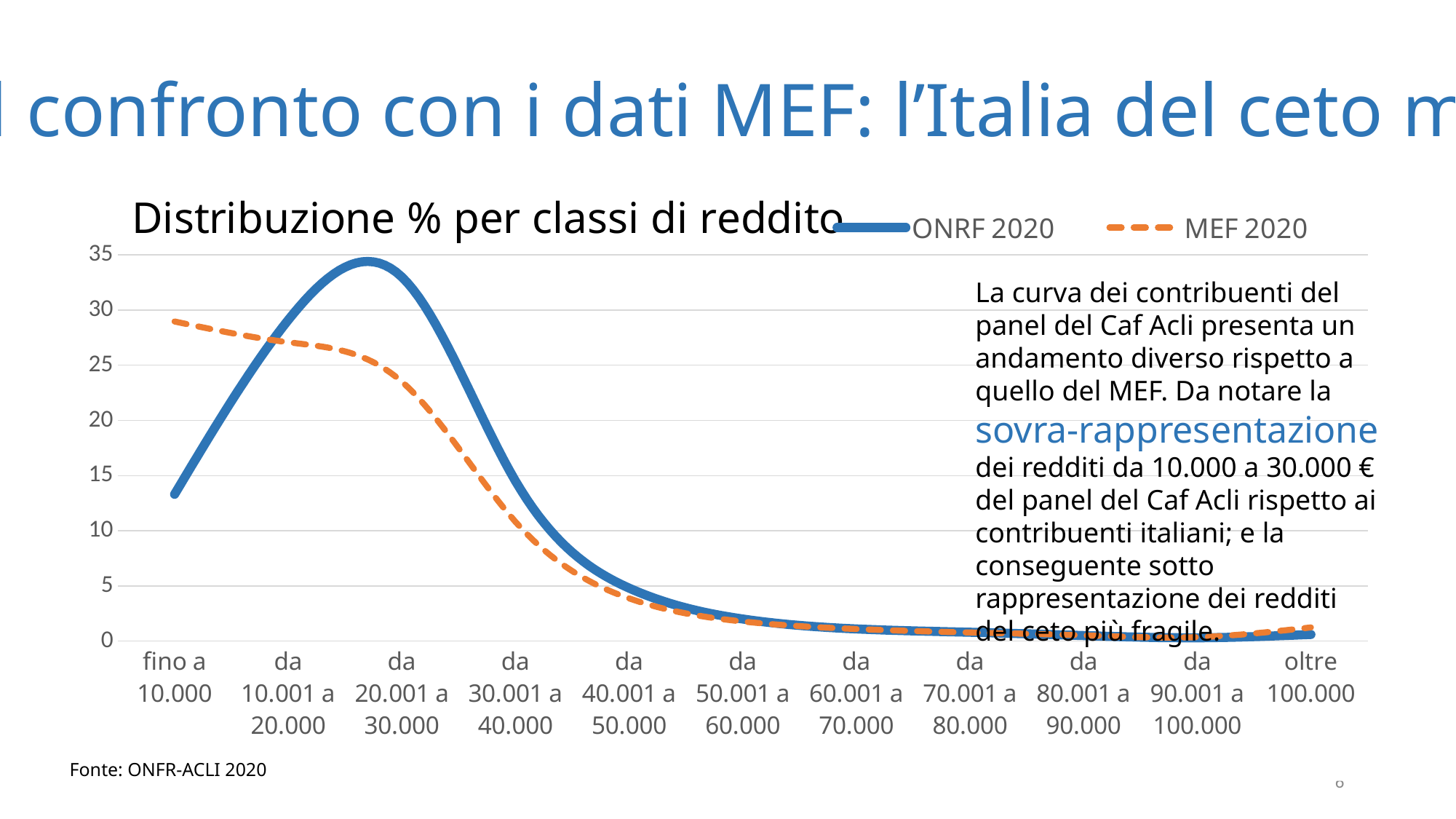
For which income class does the MEF 2020 series reach its highest value? fino a 10.000 How many series does the legend list? 2 For the income class 'fino a 10.000', which series has the higher value, ONRF 2020 or MEF 2020? MEF 2020 Which series is drawn with a dashed orange line? MEF 2020 Is the MEF 2020 value for 'fino a 10.000' greater or less than 25? greater For which income class does the ONRF 2020 series reach its highest value? da 20.001 a 30.000 How many income classes are shown on the x axis? 11 What kind of chart is shown on the slide? line chart Is the ONRF 2020 value for 'fino a 10.000' greater or less than 15? less Is the ONRF 2020 value for 'da 20.001 a 30.000' greater or less than 30? greater Does the ONRF 2020 series rise or fall from 'da 20.001 a 30.000' to 'da 50.001 a 60.000'? fall What is the title of the chart? Distribuzione % per classi di reddito